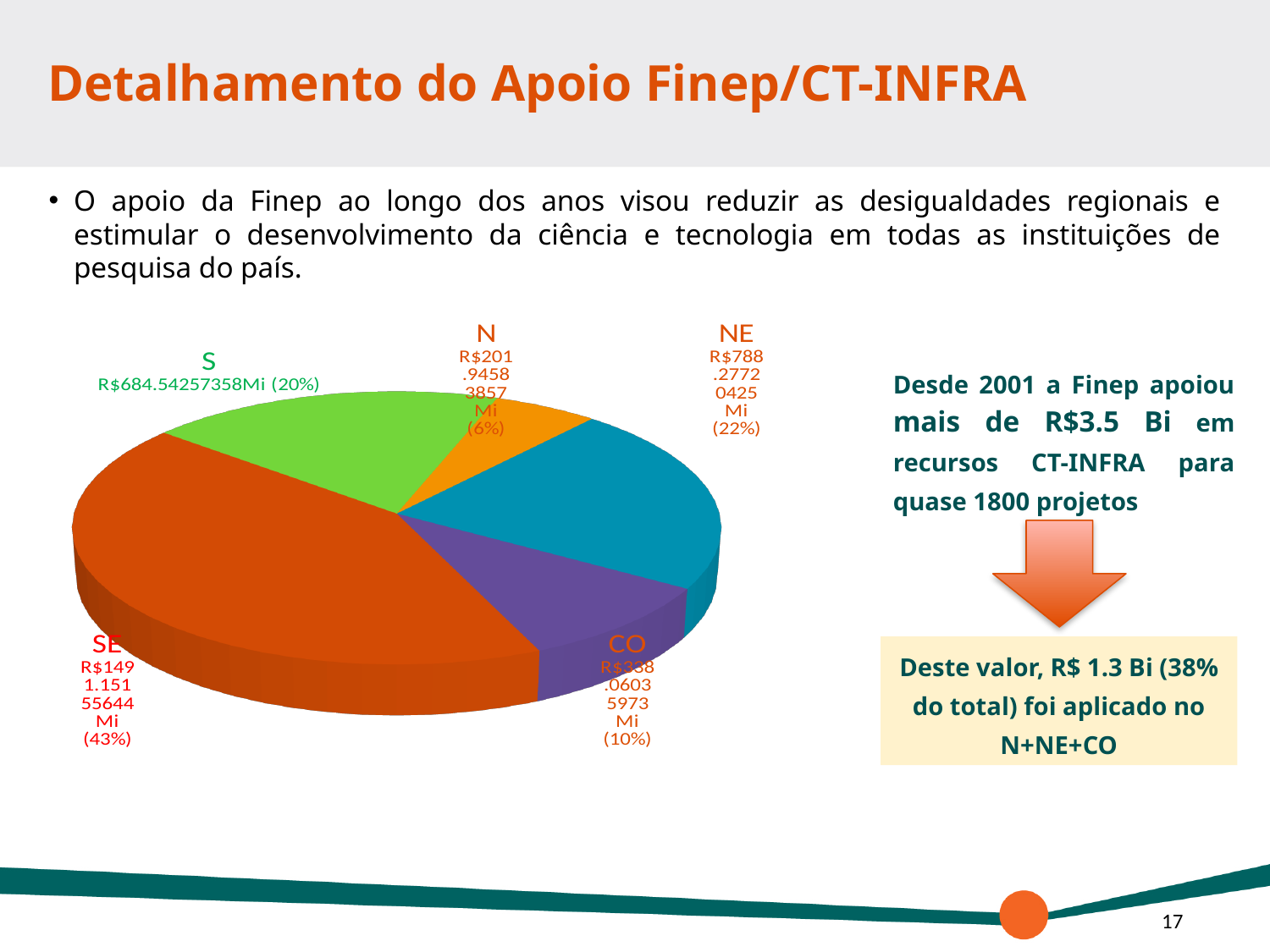
What share of the pie does the SE slice represent? 43% What share of the pie does the CO slice represent? 10% What kind of chart is shown on the slide? pie chart What share of the pie does the N slice represent? 6% Which slice is larger, NE or S? NE How many slices does the pie chart have? 5 Which region has the smallest slice of the pie? N Which region has the largest slice of the pie? SE What is the value shown for the S slice? R$684.54257358Mi What is the difference in percentage points between the SE share and the CO share? 33 percentage points